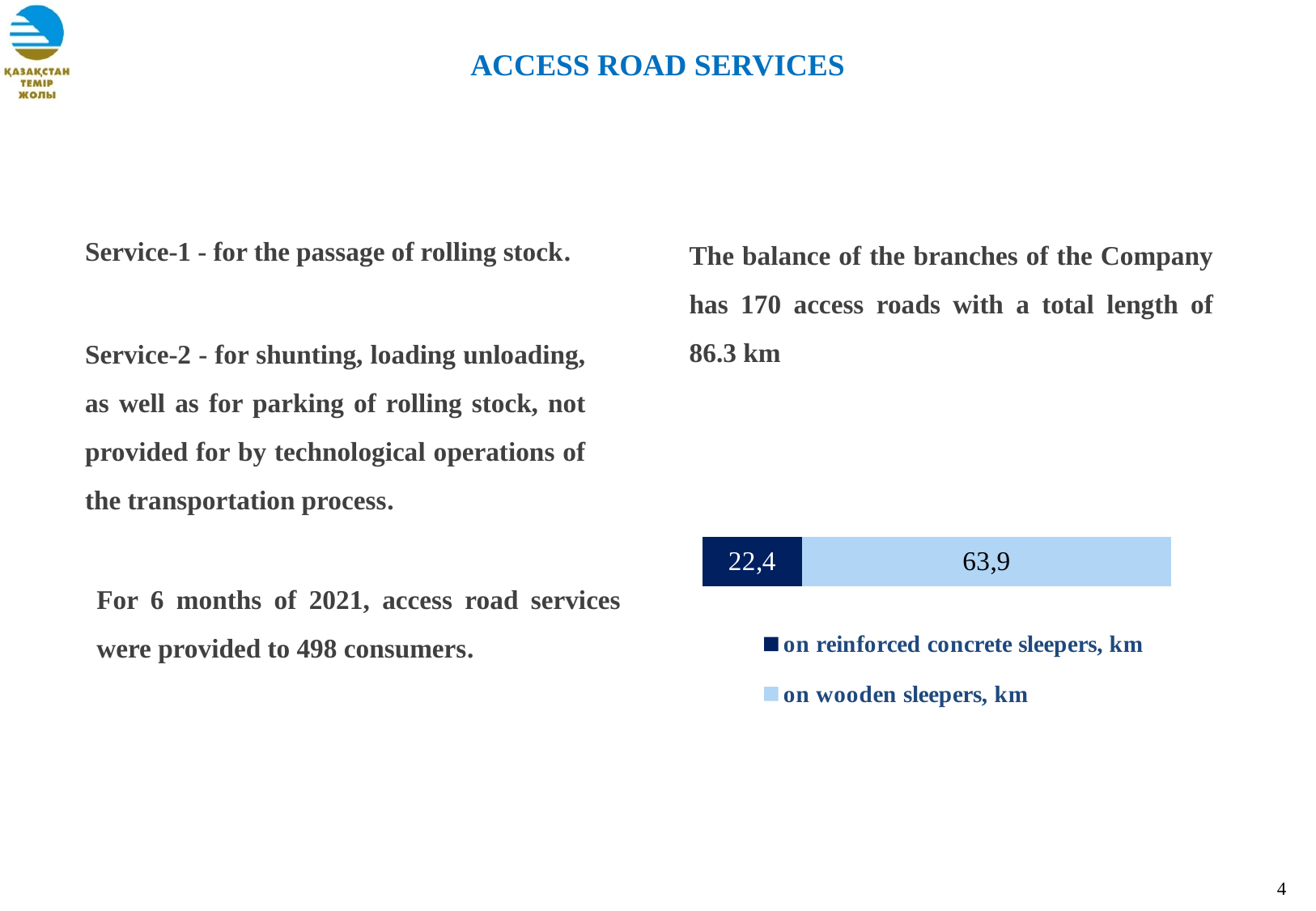
What kind of chart is shown on the slide? stacked bar chart Which series has the largest value in the bar? on wooden sleepers, km What colour is the segment for on wooden sleepers, km? light blue How many series does the legend list? 2 What is the value for on reinforced concrete sleepers, km? 22,4 What is the value for on wooden sleepers, km? 63,9 What is the total of the stacked bar? 86,3 What colour is the segment for on reinforced concrete sleepers, km? dark navy blue Which series has the smallest value in the bar? on reinforced concrete sleepers, km What is the difference between the value for on wooden sleepers and the value for on reinforced concrete sleepers? 41,5 Which series has the larger value, on reinforced concrete sleepers or on wooden sleepers? on wooden sleepers, km